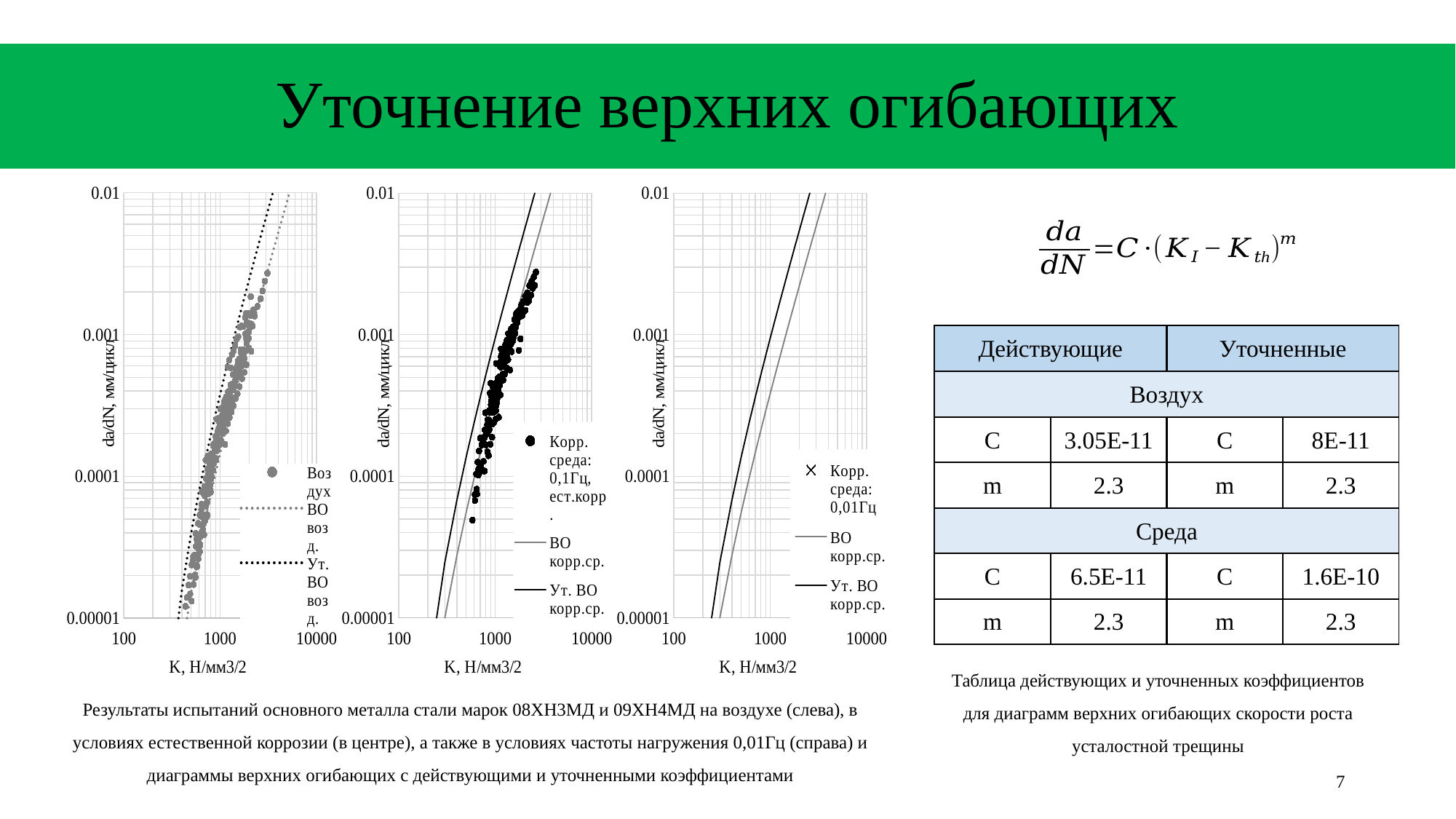
What is the y-axis label of the left chart? da/dN, мм/цикл What is the x-axis label of the center chart? K, Н/мм3/2 How many series does the legend of the right chart list? 3 What kind of chart is the left chart on the slide? scatter chart How many series does the legend of the left chart list? 3 In the left chart, do the plotted points rise or fall as K increases along the x axis? rise How many series does the legend of the center chart list? 3 How many charts are shown on the slide? 3 In the center chart, do the plotted points rise or fall as K increases along the x axis? rise